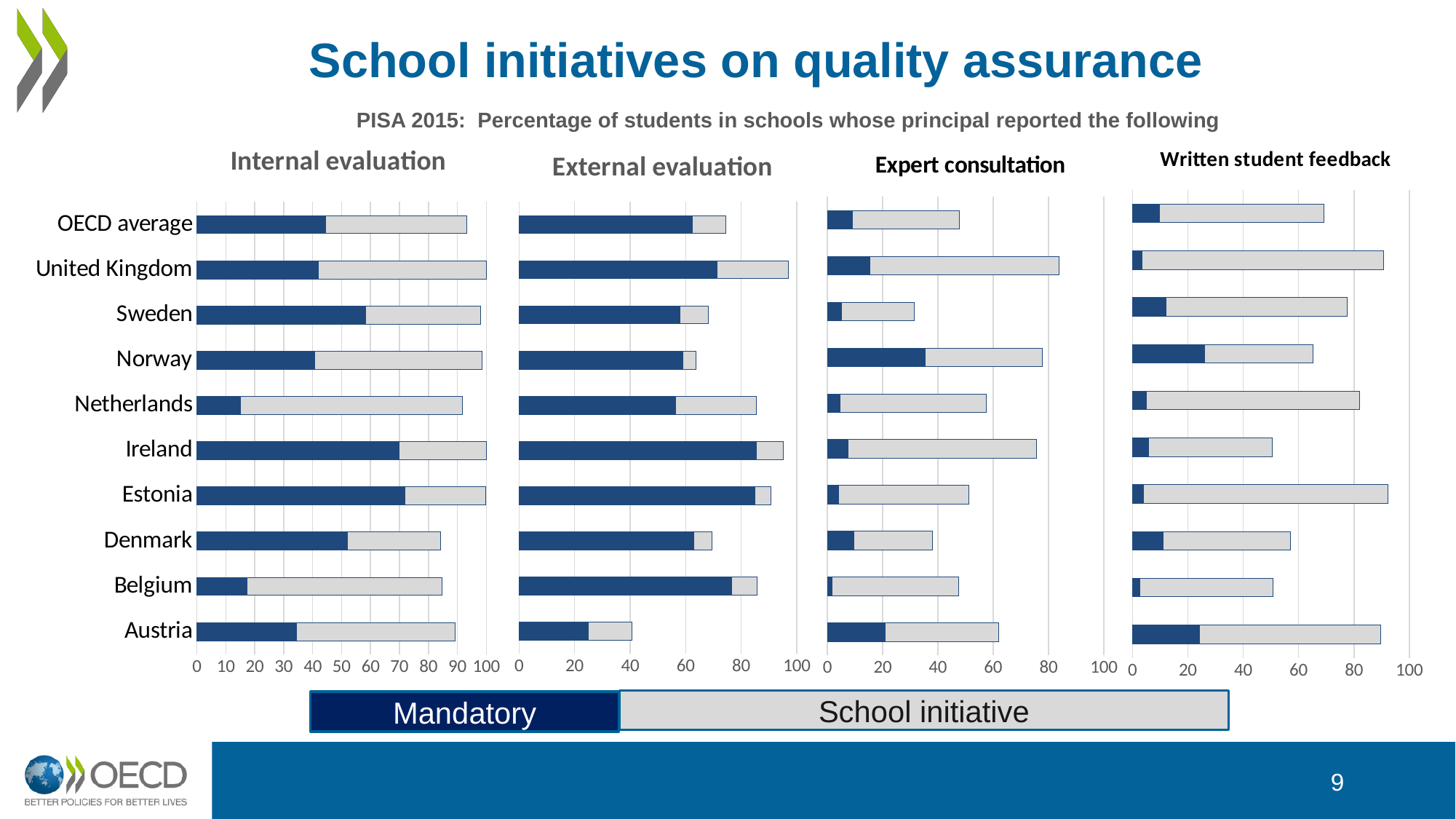
According to the legend, which colour represents Mandatory? Dark blue In the Internal evaluation chart, which has the larger Mandatory value, Ireland or Netherlands? Ireland How many countries or groups are listed on the y axis of the Internal evaluation chart? 10 In the Internal evaluation chart, is the Mandatory value for Netherlands greater or less than 20? less In the Written student feedback chart, is the Mandatory value for Belgium greater or less than 20? less How many series does the legend at the bottom of the slide list? 2 What kind of chart is used for the Internal evaluation panel? Bar chart In the Expert consultation chart, which country has the largest Mandatory segment? Norway In the External evaluation chart, which country has the shortest total bar? Austria In the Written student feedback chart, is the Mandatory value for Norway greater or less than 20? greater